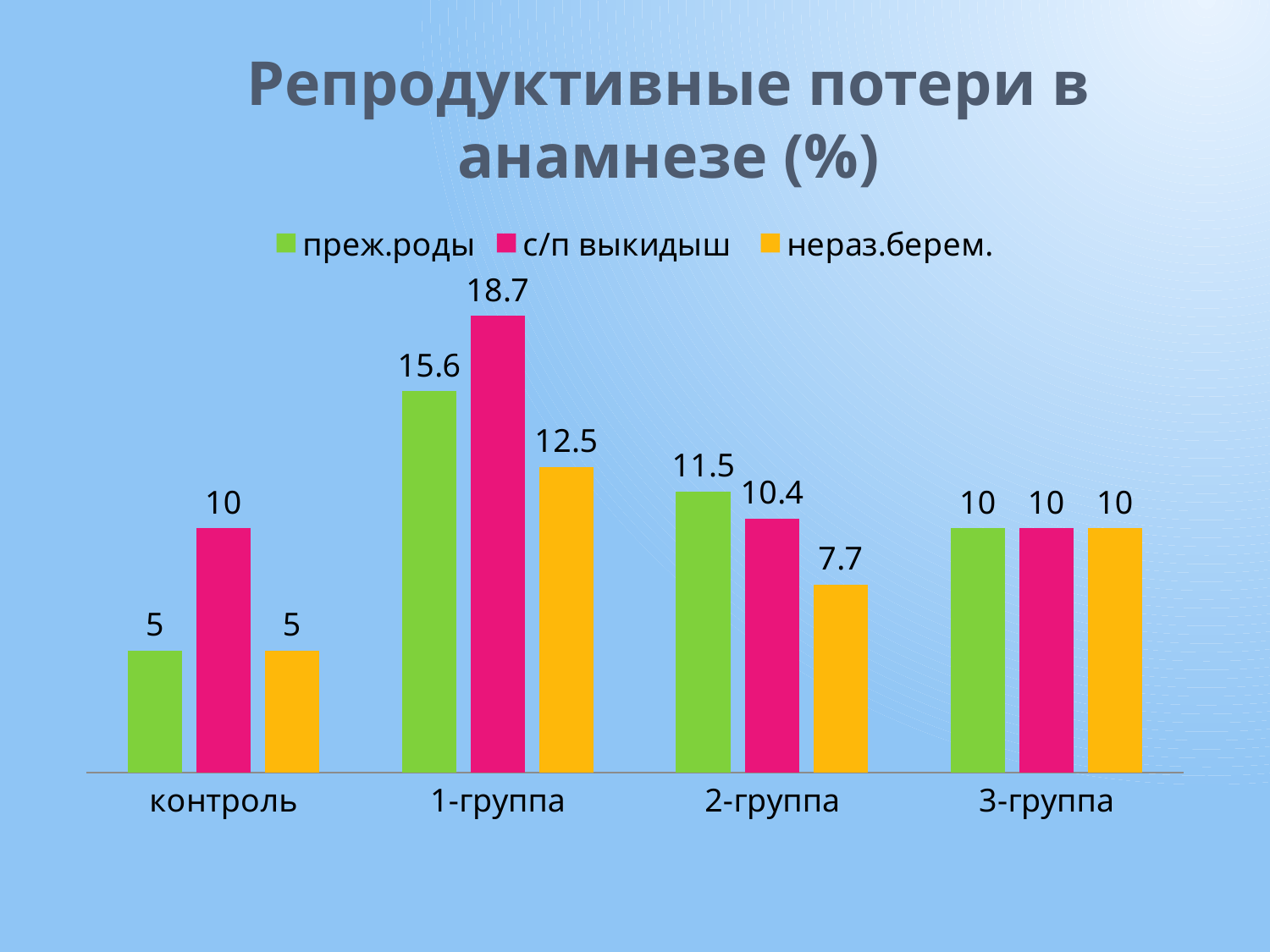
What is the difference between с/п выкидыш and преж.роды in 1-группа? 3.1 Which category has the highest value for с/п выкидыш? 1-группа What is the value for с/п выкидыш in 1-группа? 18.7 What is the value for нераз.берем. in контроль? 5 Which is larger in 2-группа: преж.роды or с/п выкидыш? преж.роды How many categories are shown on the x axis? 4 How many series does the legend list? 3 What is the value for преж.роды in 2-группа? 11.5 What is the title of the chart? Репродуктивные потери в анамнезе (%) Which category has the lowest value for преж.роды? контроль What kind of chart is shown on the slide? bar chart What is the difference between преж.роды and нераз.берем. in 2-группа? 3.8